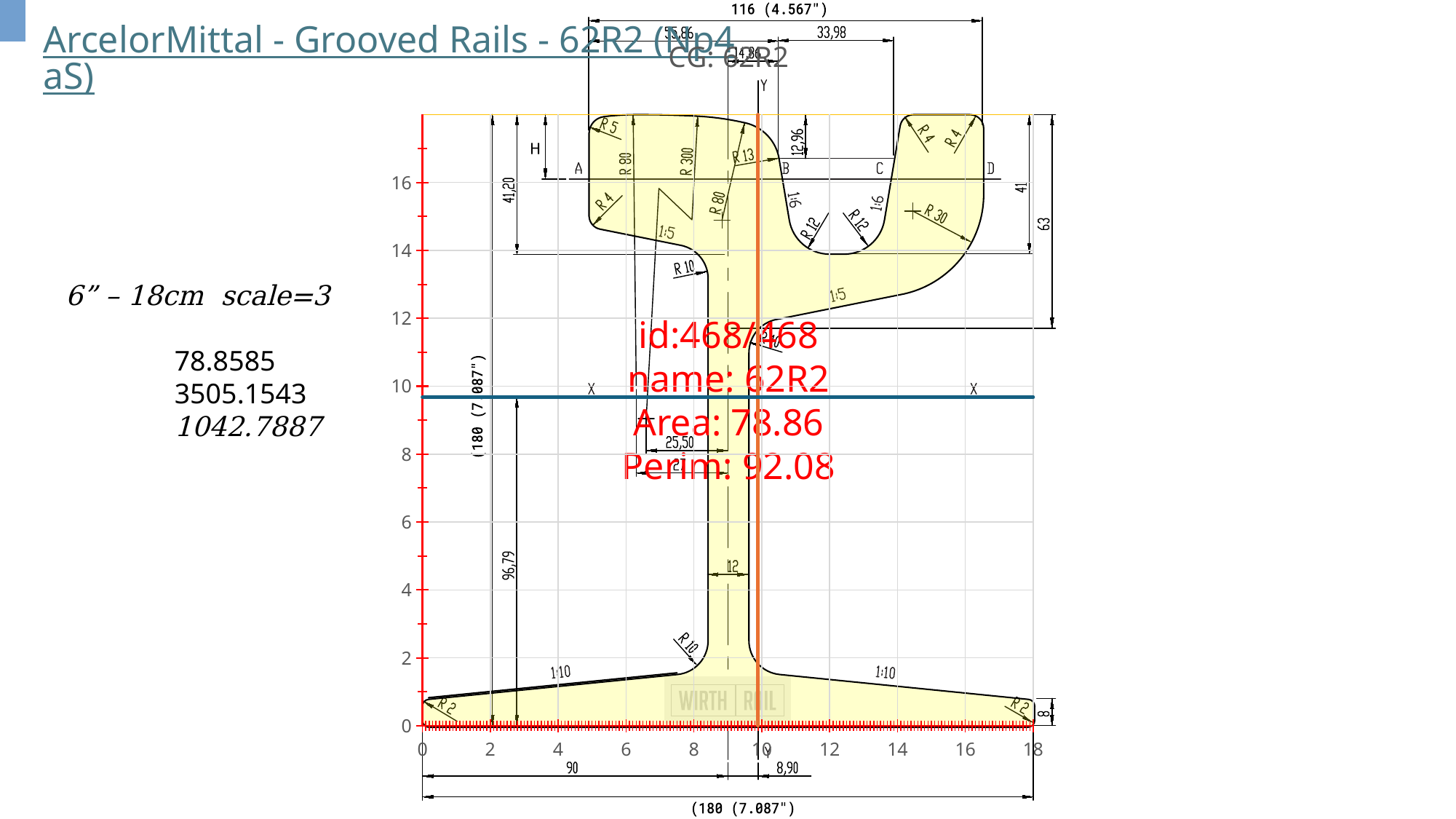
What Area value is printed on the chart? 78.86 Which printed value on the chart is larger, Area or Perim? Perim Is the Area value printed on the chart greater or less than 80? less What is the title of the chart on the slide? CG: 62R2 Is the Perim value printed on the chart greater or less than 90? greater What id is printed in the red annotation on the chart? 468/468 What is the highest tick value shown on the x axis of the chart? 18 What name is printed in the red annotation on the chart? 62R2 What Perim value is printed on the chart? 92.08 What is the difference between the Perim value and the Area value printed on the chart? 13.22